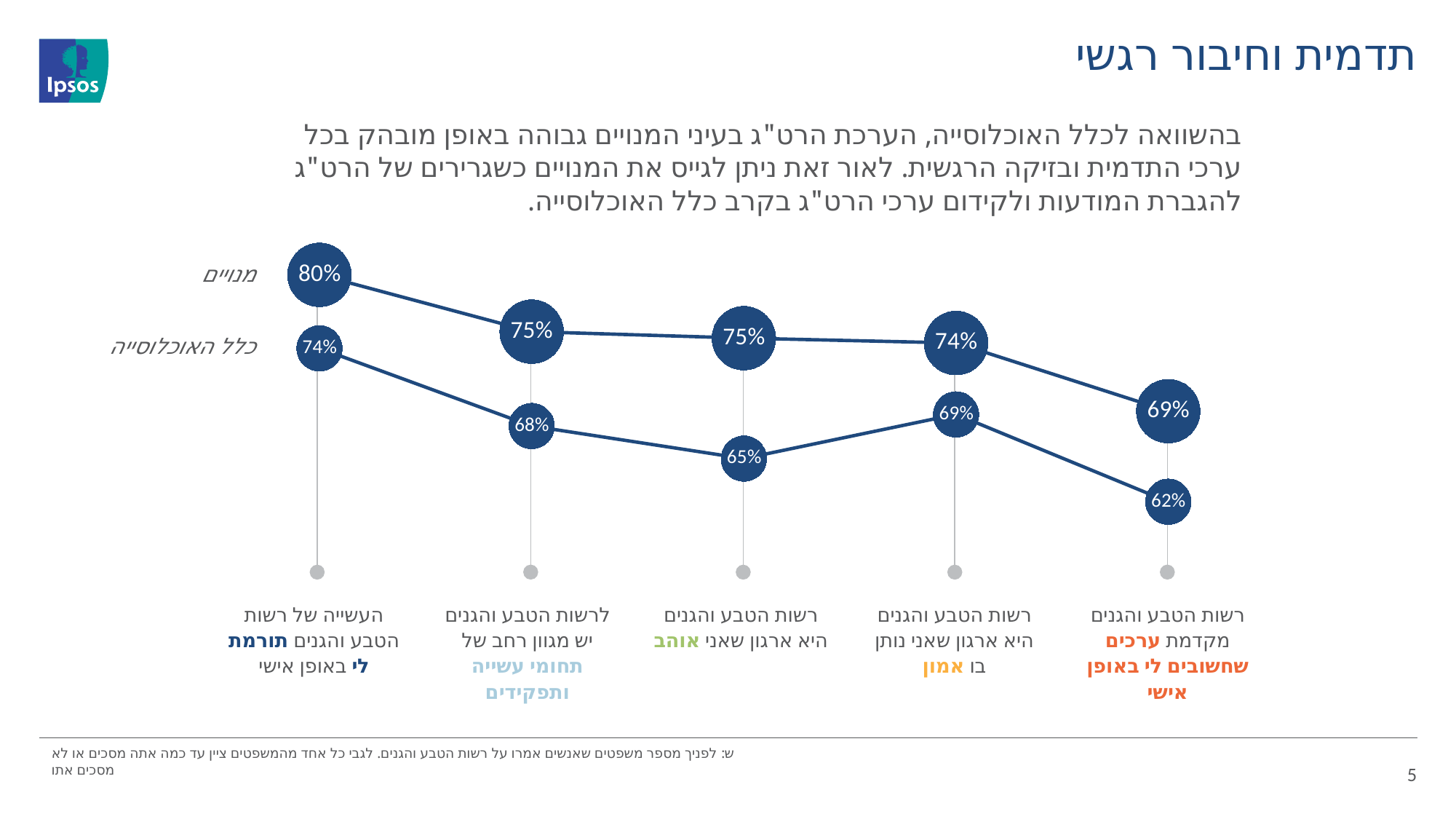
How many series are plotted in the chart? 2 What is the difference between the מנויים and כלל האוכלוסייה values for the statement "רשות הטבע והגנים מקדמת ערכים שחשובים לי באופן אישי"? 7% What is the value for the מנויים series for the statement "רשות הטבע והגנים היא ארגון שאני נותן בו אמון"? 74% Which statement has the lowest value in the כלל האוכלוסייה series? רשות הטבע והגנים מקדמת ערכים שחשובים לי באופן אישי What is the value for the כלל האוכלוסייה series for the statement "רשות הטבע והגנים היא ארגון שאני אוהב"? 65% What kind of chart is shown on the slide? Line chart What is the value for the מנויים series for the statement "העשייה של רשות הטבע והגנים תורמת לי באופן אישי"? 80% How many statements (categories) are plotted along the x axis? 5 Which statement has the highest value in the מנויים series? העשייה של רשות הטבע והגנים תורמת לי באופן אישי What is the difference between the מנויים and כלל האוכלוסייה values for the statement "רשות הטבע והגנים היא ארגון שאני אוהב"? 10% What is the value for the כלל האוכלוסייה series for the statement "רשות הטבע והגנים מקדמת ערכים שחשובים לי באופן אישי"? 62% For the statement "לרשות הטבע והגנים יש מגוון רחב של תחומי עשייה ותפקידים", which series has the larger value, מנויים or כלל האוכלוסייה? מנויים